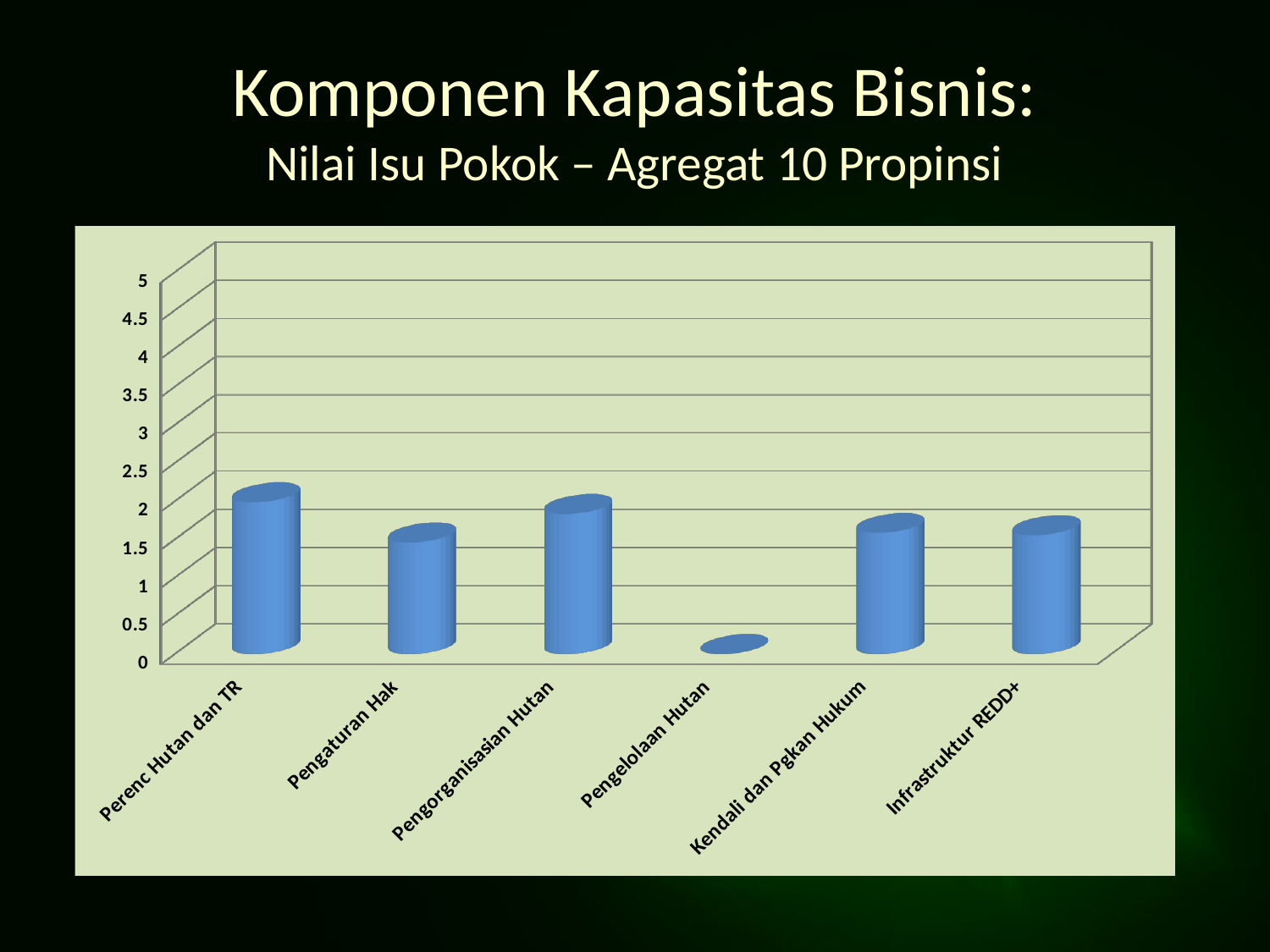
Which is larger, the value for Perenc Hutan dan TR or the value for Pengaturan Hak? Perenc Hutan dan TR Which category has the lowest value in the chart? Pengelolaan Hutan How many categories are shown on the x axis of the chart? 6 Is the value for Pengaturan Hak greater or less than 2? less Is the value for Perenc Hutan dan TR greater or less than 1.5? greater Is the value for Kendali dan Pgkan Hukum greater or less than 1? greater Which category has the highest value in the chart? Perenc Hutan dan TR Which is larger, the value for Pengorganisasian Hutan or the value for Pengelolaan Hutan? Pengorganisasian Hutan What is the subtitle of the slide below 'Komponen Kapasitas Bisnis:'? Nilai Isu Pokok – Agregat 10 Propinsi What kind of chart is shown on the slide? Bar chart